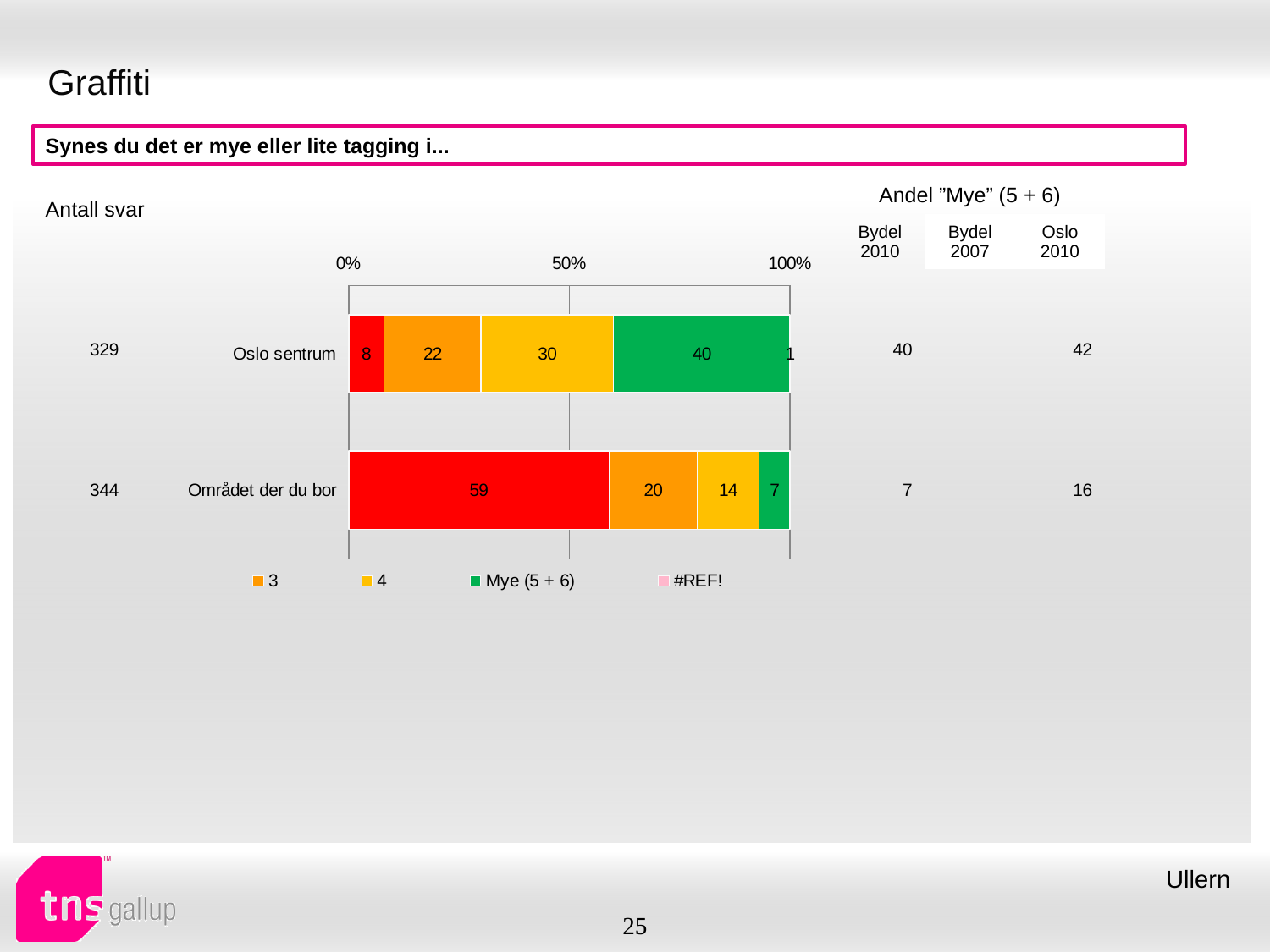
What is the 'Antall svar' (number of responses) shown for Oslo sentrum? 329 What is the value of the '3' segment for Oslo sentrum? 22 What is the value of the 'Mye (5 + 6)' segment for Oslo sentrum? 40 How many categories (bars) does the chart show? 2 What is the difference between the 'Mye (5 + 6)' values for Oslo sentrum and Området der du bor? 33 Which category has the larger 'Mye (5 + 6)' segment, Oslo sentrum or Området der du bor? Oslo sentrum What is the value of the 'Mye (5 + 6)' segment for Området der du bor? 7 What is the value of the '4' segment for Området der du bor? 14 Is the red segment for Området der du bor greater or less than 50%? greater What is the last entry listed in the chart legend? #REF! What kind of chart is shown on the slide? Stacked bar chart What is the value of the red segment for Området der du bor? 59